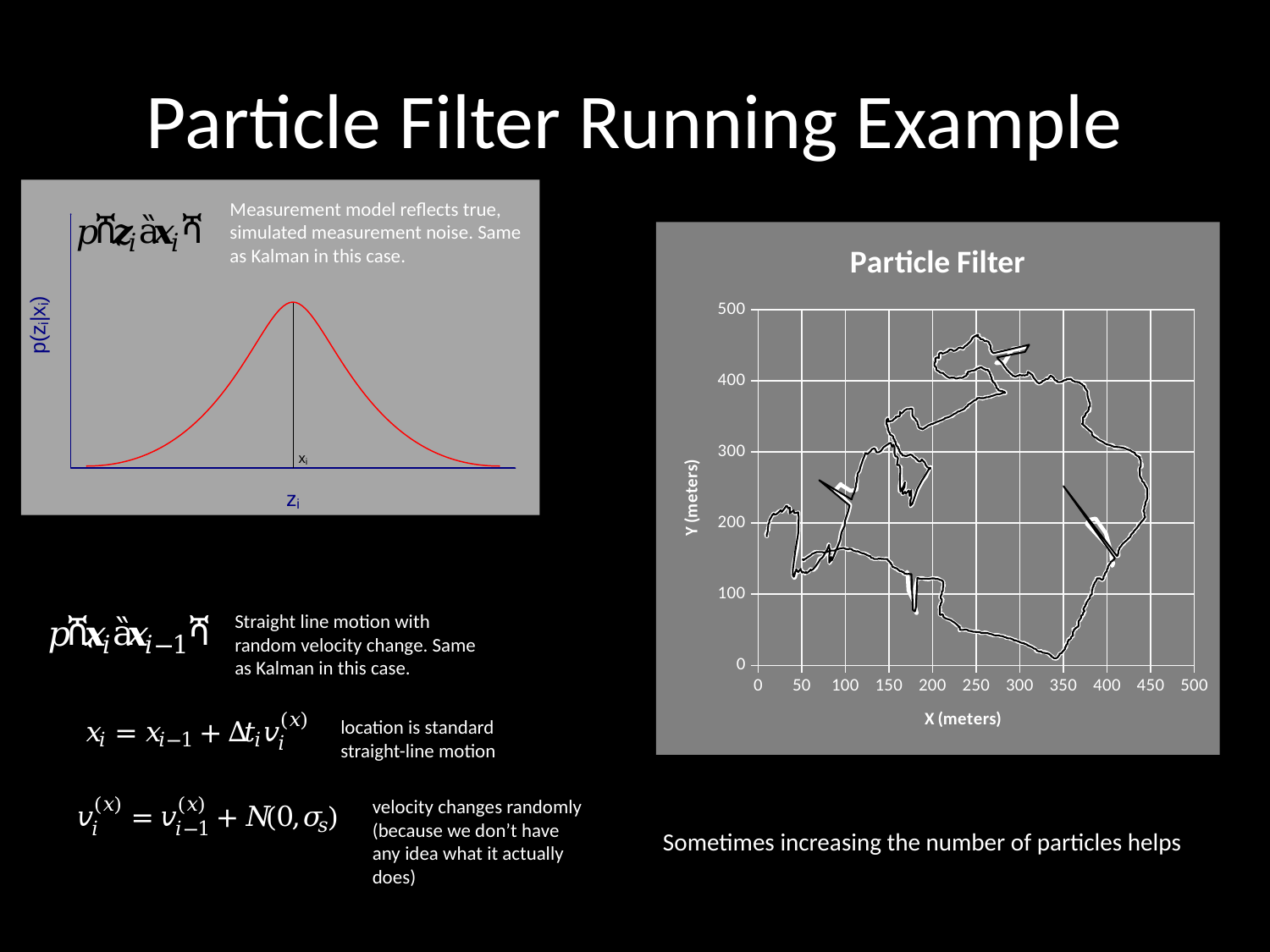
In the 'Particle Filter' chart, what is the highest value shown on the Y (meters) axis? 500 In the 'Particle Filter' chart, what is the label of the vertical axis? Y (meters) What kind of chart is the 'Particle Filter' chart? Line chart (trajectory plot) In the 'Particle Filter' chart, what is the highest value shown on the X (meters) axis? 500 What is the title of the chart on the right side of the slide? Particle Filter In the 'Particle Filter' chart, what is the spacing between consecutive tick marks on the X (meters) axis? 50 In the 'Particle Filter' chart, what is the label of the horizontal axis? X (meters) In the 'Particle Filter' chart, what is the spacing between consecutive tick marks on the Y (meters) axis? 100 In the 'Particle Filter' chart, does the plotted trajectory ever exceed a Y value of 400? Yes